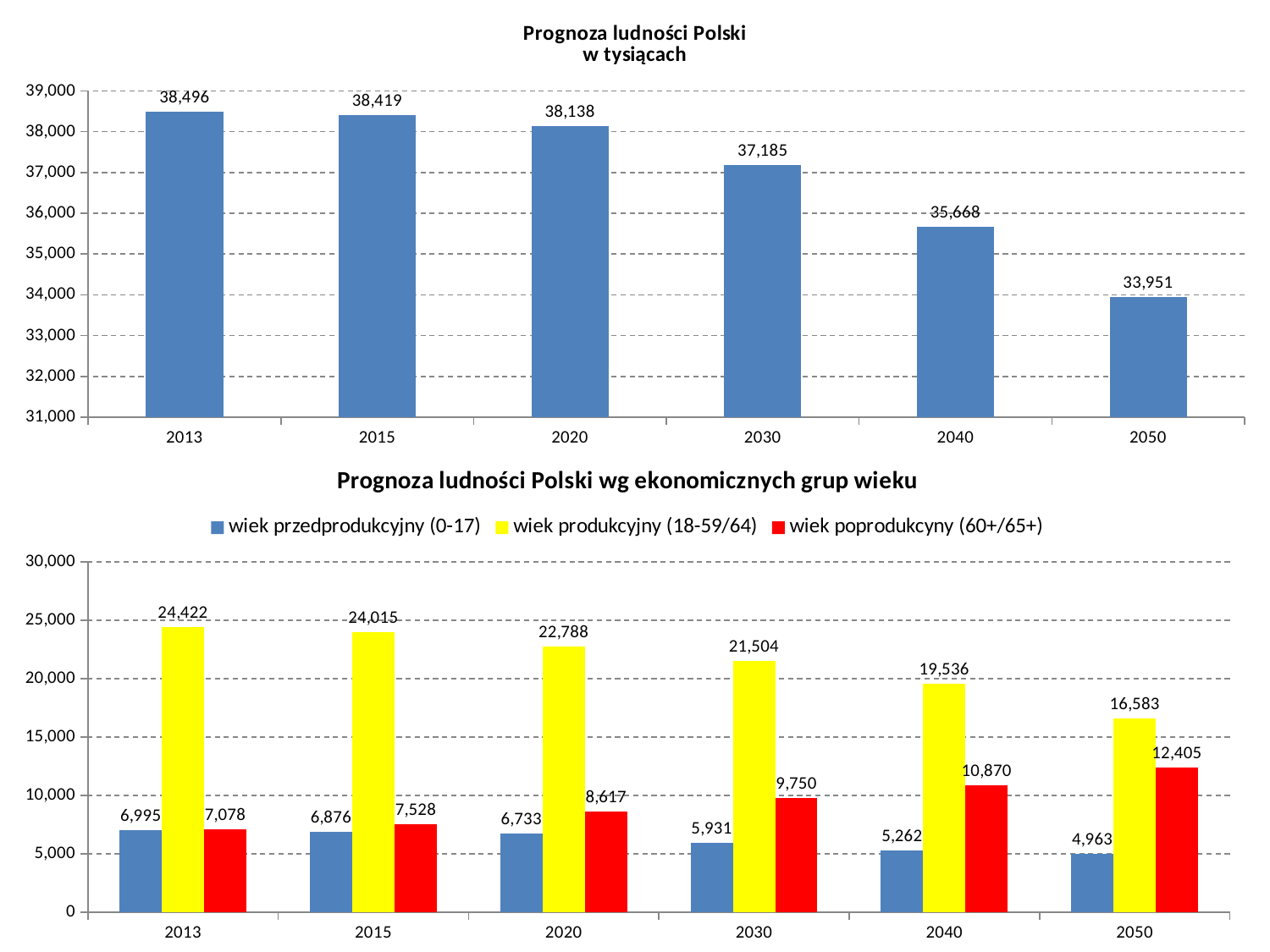
In the top chart 'Prognoza ludności Polski w tysiącach', which year has the lowest value? 2050 In the bottom chart 'Prognoza ludności Polski wg ekonomicznych grup wieku', what is the difference between wiek produkcyjny (18-59/64) in 2013 and in 2050? 7,839 In the bottom chart 'Prognoza ludności Polski wg ekonomicznych grup wieku', what is the value for wiek produkcyjny (18-59/64) in 2040? 19,536 In the top chart 'Prognoza ludności Polski w tysiącach', what is the value for 2030? 37,185 What type of chart is the top chart 'Prognoza ludności Polski w tysiącach'? bar chart In the bottom chart 'Prognoza ludności Polski wg ekonomicznych grup wieku', which colour represents wiek produkcyjny (18-59/64)? yellow In the top chart 'Prognoza ludności Polski w tysiącach', how many years are shown on the x axis? 6 In the bottom chart 'Prognoza ludności Polski wg ekonomicznych grup wieku', which is larger in 2050: wiek przedprodukcyjny (0-17) or wiek poprodukcyny (60+/65+)? wiek poprodukcyny (60+/65+) In the top chart 'Prognoza ludności Polski w tysiącach', do the values rise or fall from 2013 to 2050? fall In the top chart 'Prognoza ludności Polski w tysiącach', what is the difference between the values for 2013 and 2050? 4,545 In the bottom chart 'Prognoza ludności Polski wg ekonomicznych grup wieku', how many series does the legend list? 3 In the bottom chart 'Prognoza ludności Polski wg ekonomicznych grup wieku', what is the value for wiek poprodukcyny (60+/65+) in 2020? 8,617